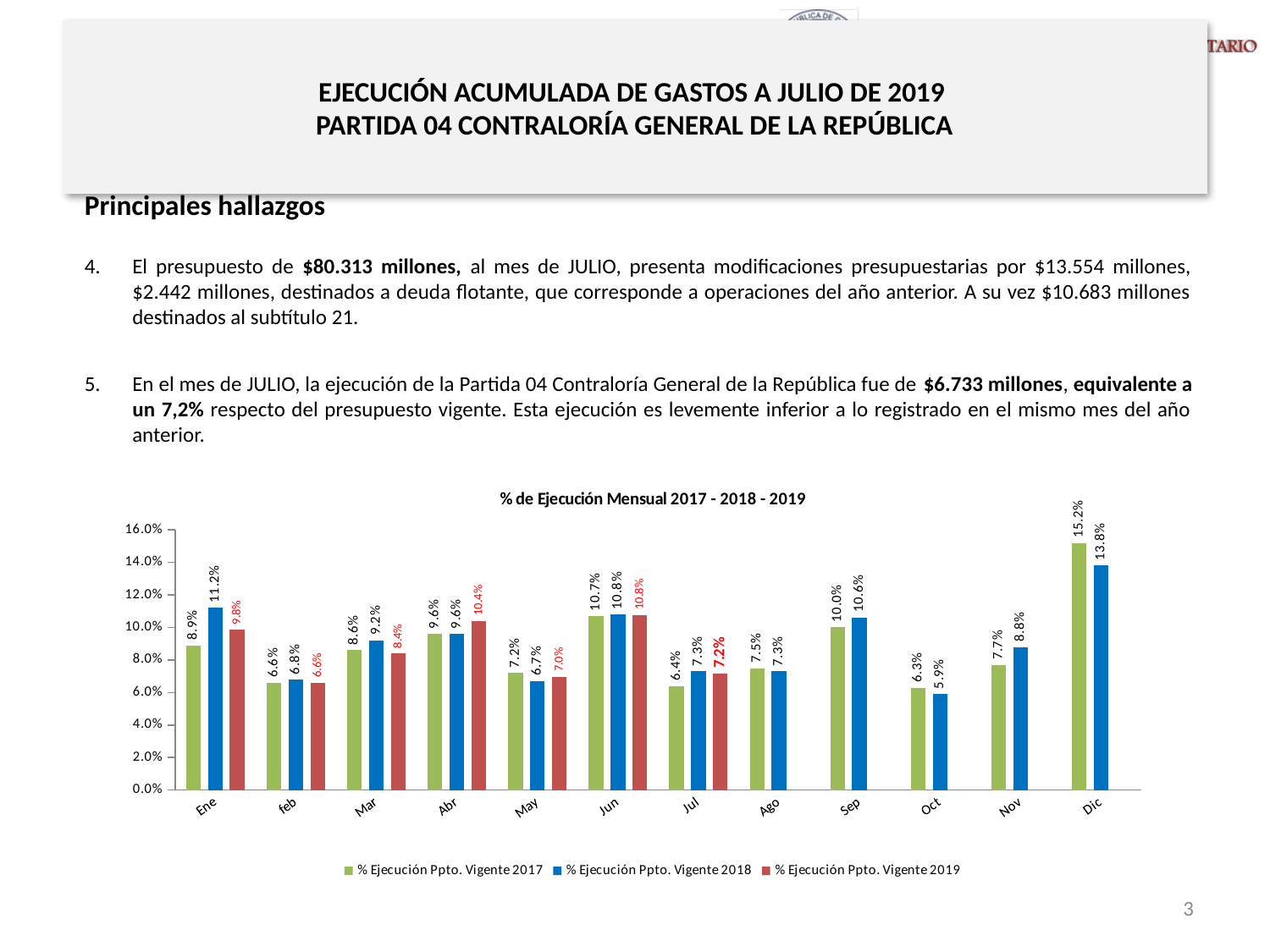
How many months are shown on the x axis? 12 What is the value for Abr in the % Ejecución Ppto. Vigente 2019 series? 10.4% Is the value for Dic in the 2017 series greater or less than 14.0%? greater What kind of chart is shown on the slide? bar chart What is the value for Jul in the % Ejecución Ppto. Vigente 2017 series? 6.4% Which is larger for Dic: the 2017 value or the 2018 value? 2017 Which month has the lowest value in the % Ejecución Ppto. Vigente 2018 series? Oct Which month has the highest value in the % Ejecución Ppto. Vigente 2017 series? Dic How many series does the legend list? 3 What is the title of the chart? % de Ejecución Mensual 2017 - 2018 - 2019 What is the value for Ene in the % Ejecución Ppto. Vigente 2018 series? 11.2% What is the difference between the 2018 and 2017 values for Ene? 2.3%